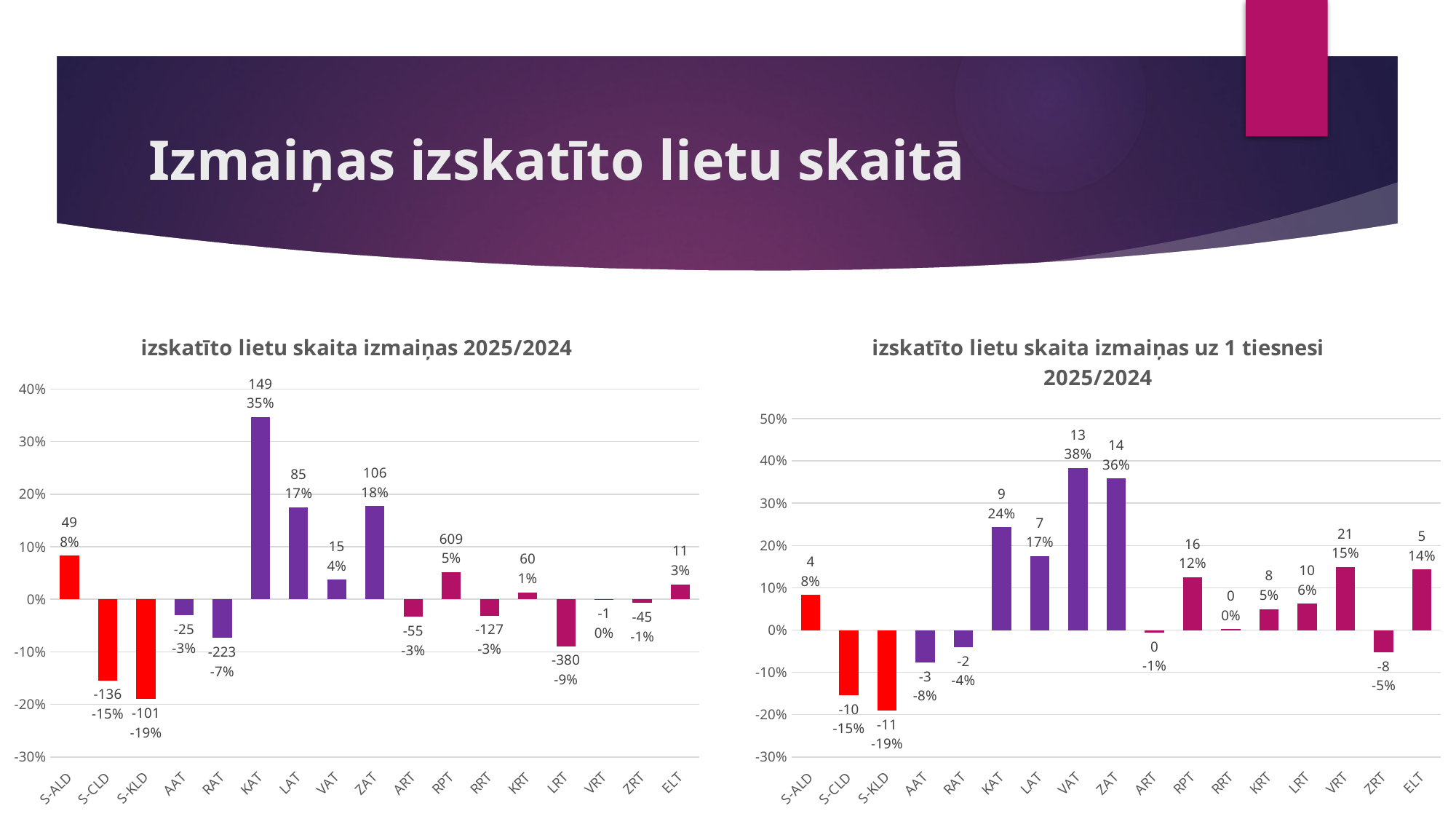
What type of chart is used on the left side of the slide? Bar chart In the right chart (izskatīto lietu skaita izmaiņas uz 1 tiesnesi 2025/2024), what is the number shown above the bar for VRT? 21 In the left chart (izskatīto lietu skaita izmaiņas 2025/2024), how many categories are shown on the x axis? 17 In the left chart (izskatīto lietu skaita izmaiņas 2025/2024), what percentage change is shown for KAT? 35% In the left chart (izskatīto lietu skaita izmaiņas 2025/2024), what is the number shown above the bar for RPT? 609 In the right chart (izskatīto lietu skaita izmaiņas uz 1 tiesnesi 2025/2024), what percentage change is shown for VAT? 38% In the left chart (izskatīto lietu skaita izmaiņas 2025/2024), which category has the highest percentage change? KAT In the right chart (izskatīto lietu skaita izmaiņas uz 1 tiesnesi 2025/2024), is the value for ZAT greater or less than 30%? greater In the right chart (izskatīto lietu skaita izmaiņas uz 1 tiesnesi 2025/2024), which category has the highest percentage change? VAT In the right chart (izskatīto lietu skaita izmaiņas uz 1 tiesnesi 2025/2024), which is larger, the percentage change for KAT or for RPT? KAT In the left chart (izskatīto lietu skaita izmaiņas 2025/2024), what is the difference in percentage points between ZAT (18%) and LAT (17%)? 1 percentage point In the left chart (izskatīto lietu skaita izmaiņas 2025/2024), which category has the lowest percentage change? S-KLD